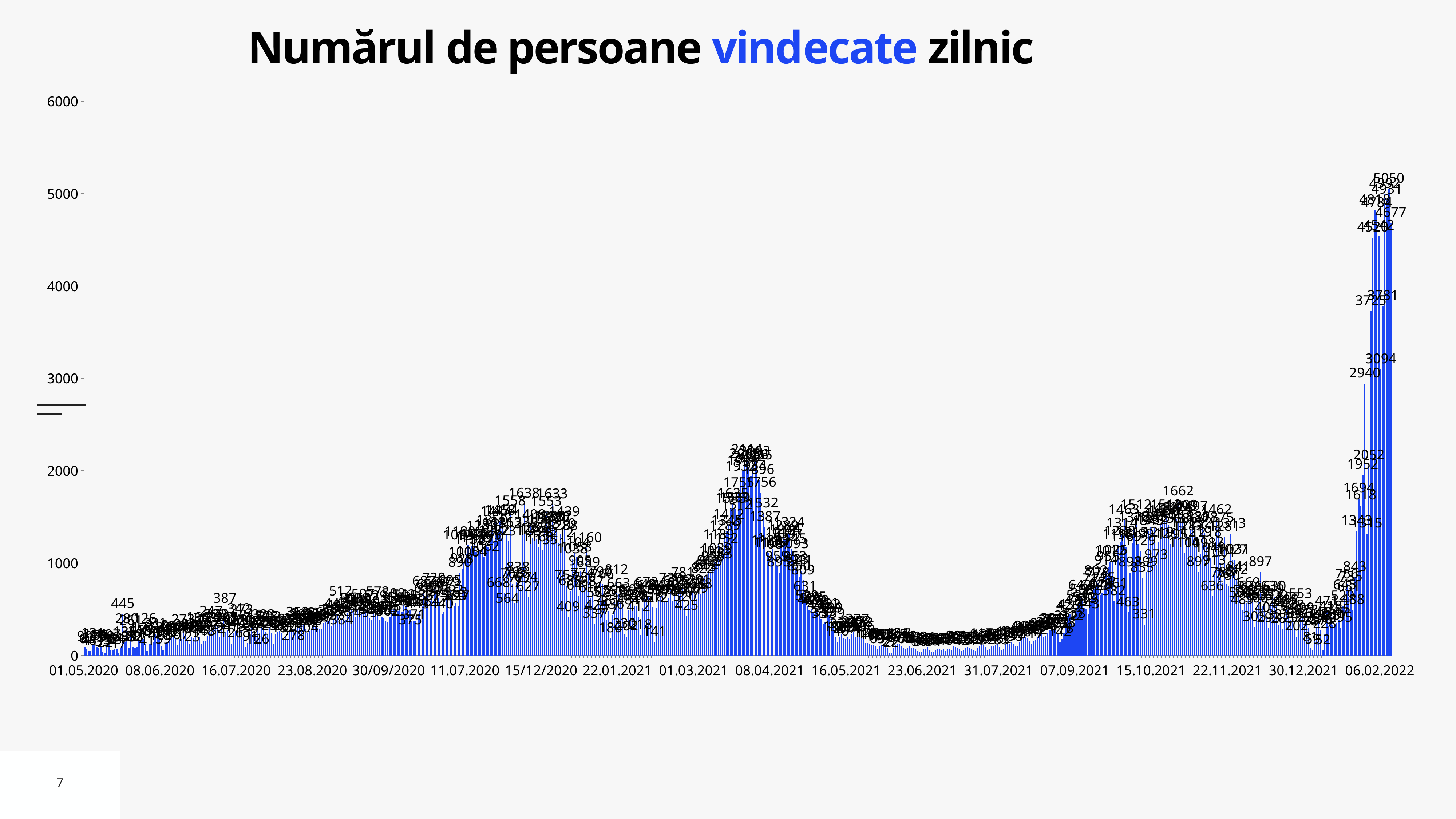
Are the values around 23.06.2021 greater or less than 500? less What is the highest value labeled at the peak around 15.10.2021? 1662 What is the first date label on the x axis? 01.05.2020 Is the peak value around 08.04.2021 greater or less than 2000? greater Do the values rise or fall between 30.12.2021 and 06.02.2022? rise Do the values rise or fall between 08.04.2021 and 23.06.2021? fall What is the highest data label shown on the chart? 5050 What is the title of the chart? Numărul de persoane vindecate zilnic What is the difference between the labeled values 5050 and 4677 at the end of the chart? 373 What kind of chart is shown on the slide? bar chart Which peak is higher: the one near 06.02.2022 or the one near 08.04.2021? the one near 06.02.2022 Is the peak value around 15.10.2021 greater or less than 2000? less